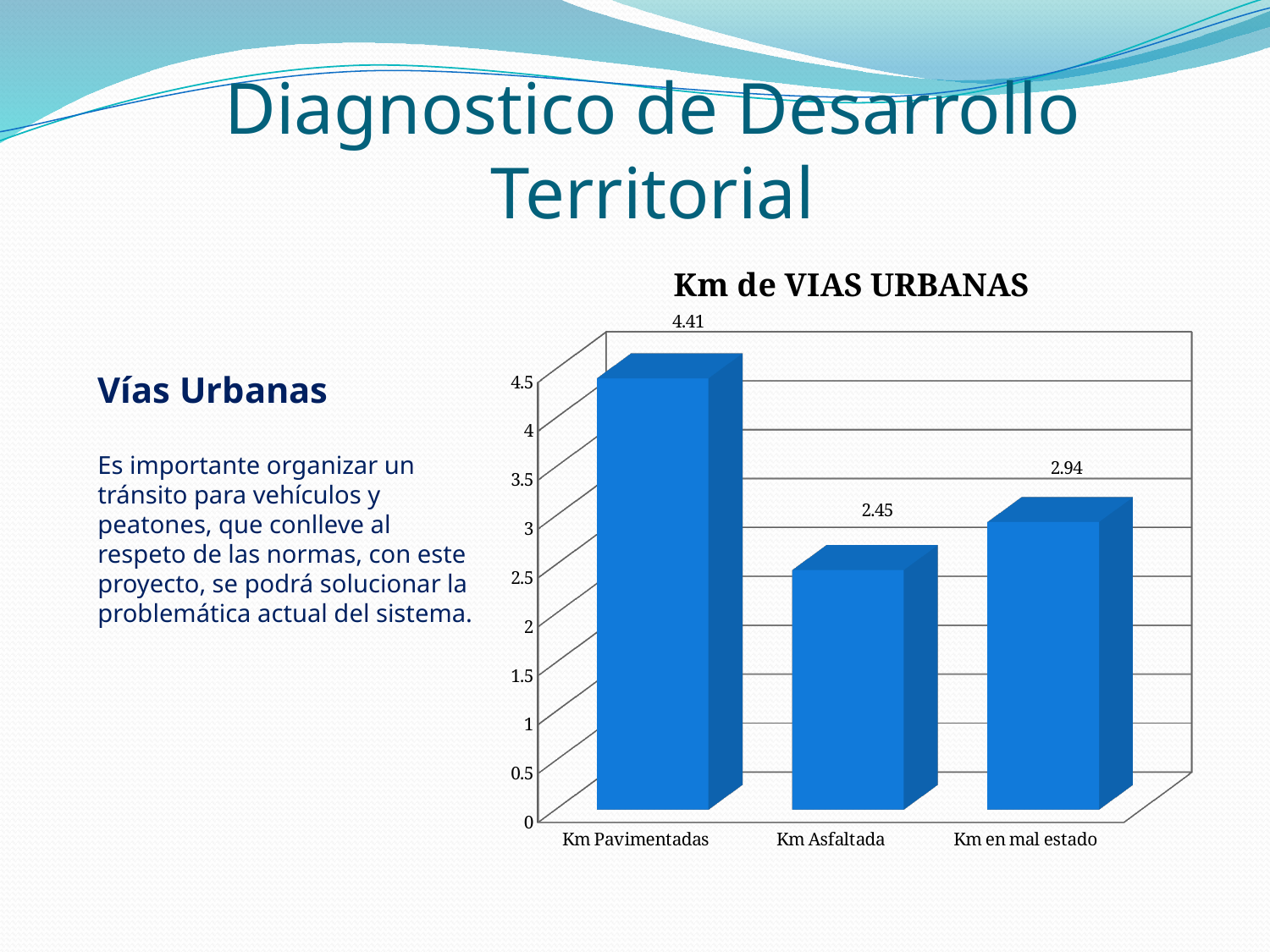
What kind of chart is shown on the slide? bar chart Is the value for Km Pavimentadas greater or less than 4? greater How many categories are shown in the chart? 3 What is the title of the chart? Km de VIAS URBANAS Which category has the lowest value? Km Asfaltada What is the difference between the values for Km en mal estado and Km Asfaltada? 0.49 What is the value for Km en mal estado? 2.94 What is the difference between the values for Km Pavimentadas and Km Asfaltada? 1.96 Which category has the highest value? Km Pavimentadas What is the value for Km Pavimentadas? 4.41 Which is larger, the value for Km en mal estado or the value for Km Asfaltada? Km en mal estado What is the value for Km Asfaltada? 2.45